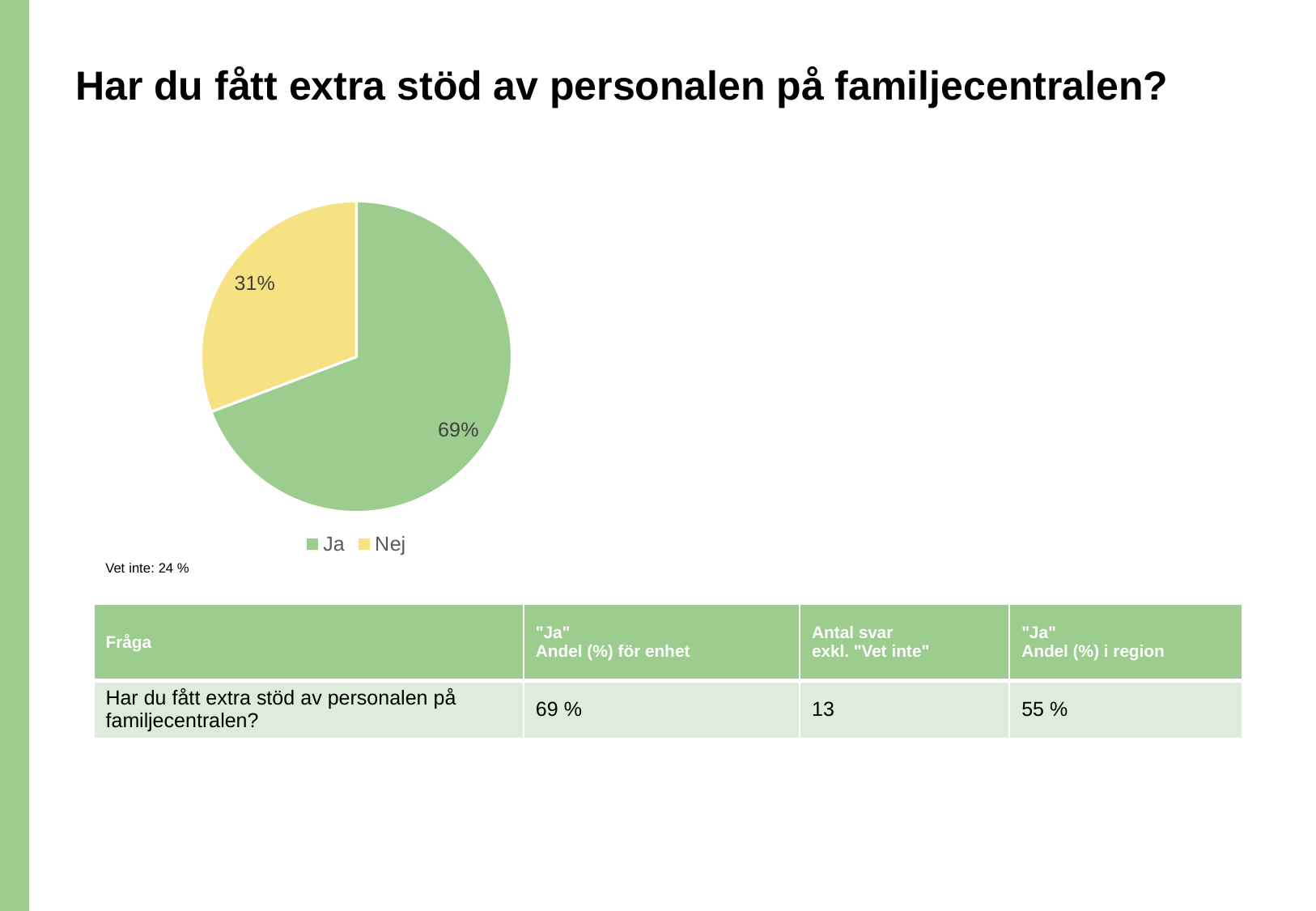
What share of the pie does the "Nej" slice represent? 31% How many slices does the pie chart have? 2 What share of the pie does the "Ja" slice represent? 69% Which slice of the pie is the largest? Ja What colour is the "Nej" slice in the pie chart? yellow What kind of chart is shown on the slide? pie chart What is the difference in percentage points between the "Ja" and "Nej" slices? 38 What colour is the "Ja" slice in the pie chart? green How many entries does the legend list? 2 Which is larger, the "Ja" slice or the "Nej" slice? Ja Which slice of the pie is the smallest? Nej